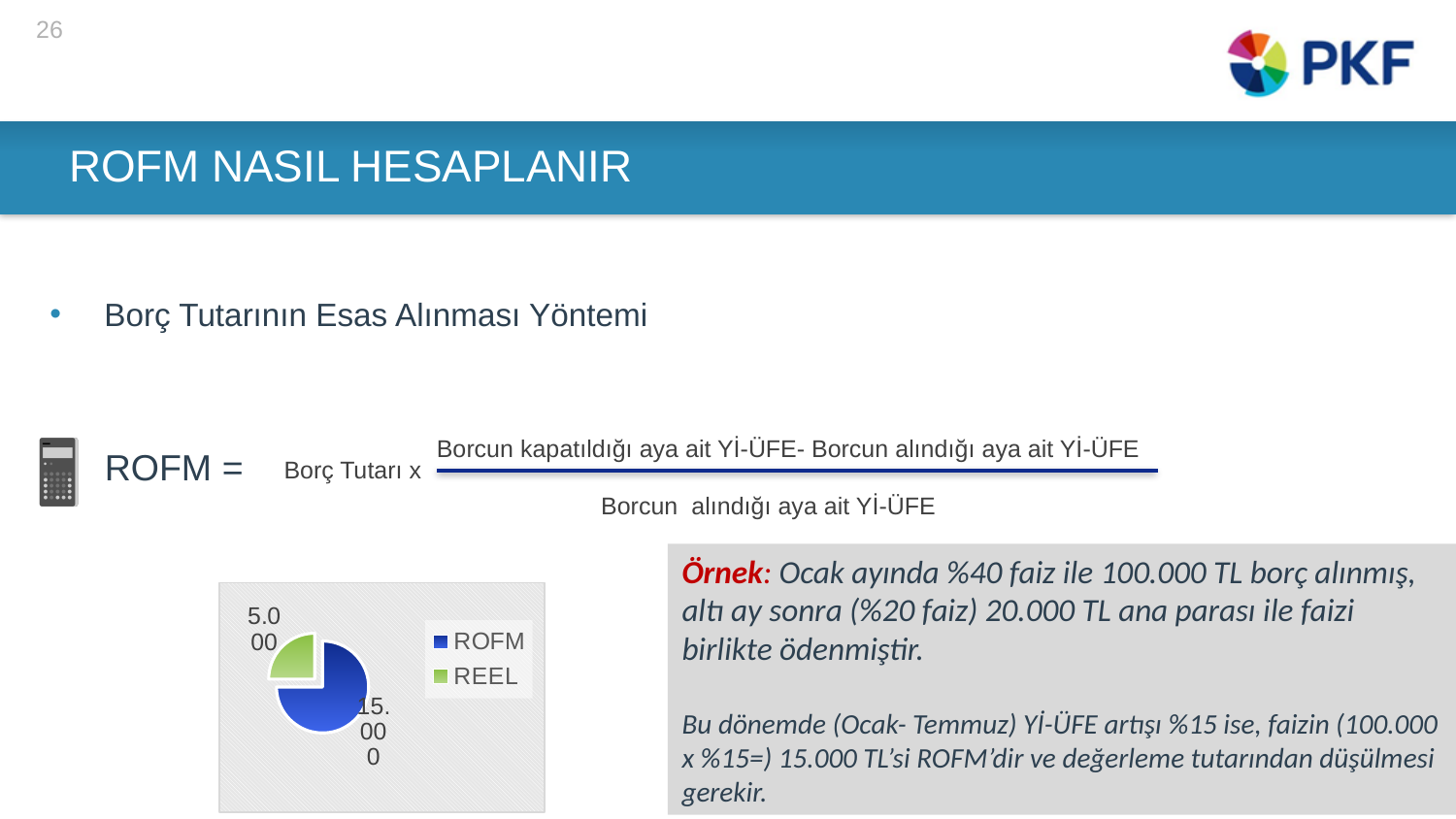
Which slice of the pie chart is the smallest? REEL What is the value shown for ROFM in the pie chart? 15.000 What is the difference between the ROFM and REEL values in the pie chart? 10.000 Which is larger in the pie chart, ROFM or REEL? ROFM Which slice of the pie chart is the largest? ROFM How many slices does the pie chart have? 2 What kind of chart is shown on the slide? pie chart How many series does the legend of the pie chart list? 2 What share of the pie does the ROFM slice represent? 75% What is the value shown for REEL in the pie chart? 5.000 What colour is the REEL slice in the pie chart? green What colour is the ROFM slice in the pie chart? blue